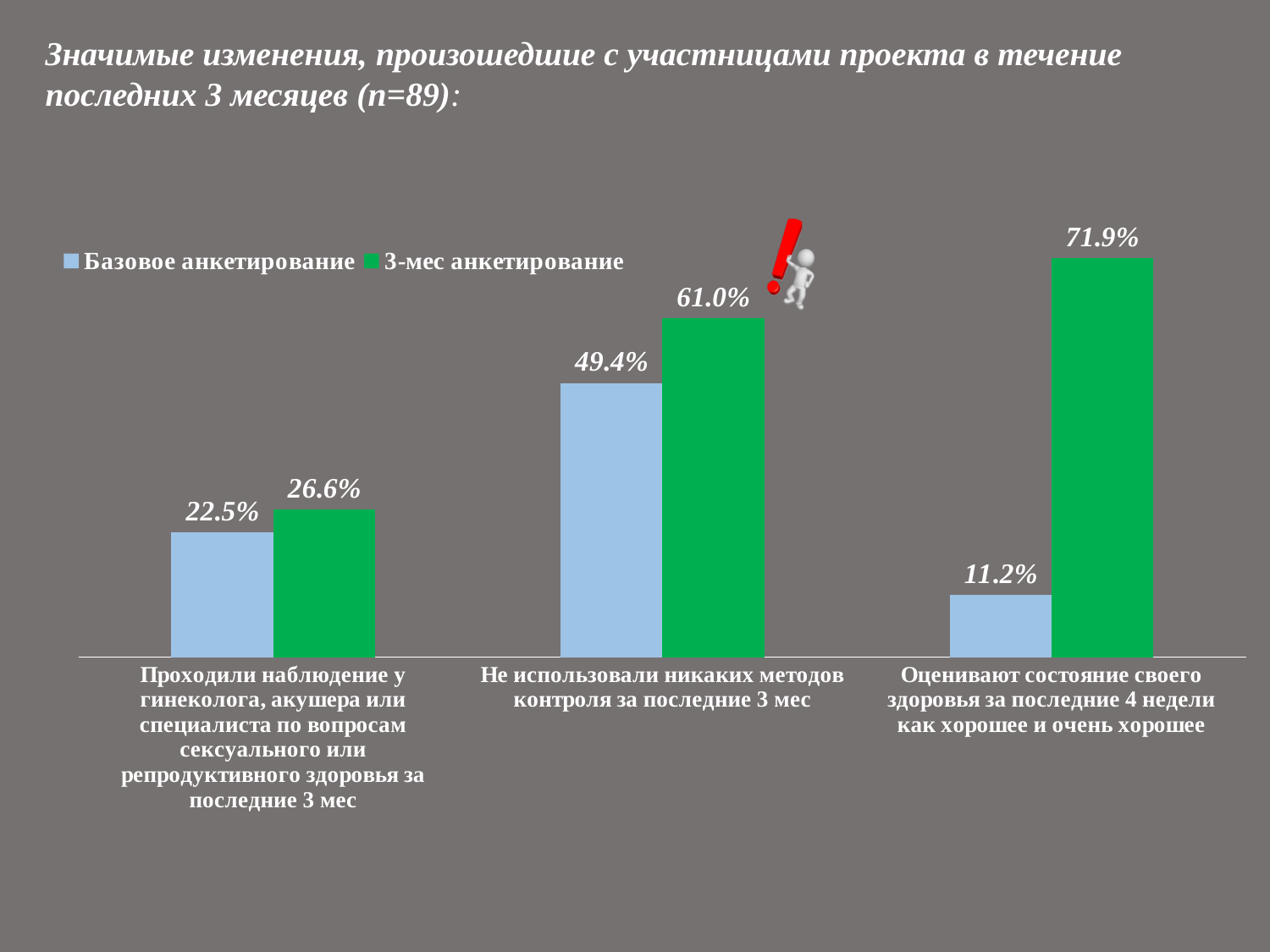
What is the difference between the "3-мес анкетирование" and "Базовое анкетирование" values for "Оценивают состояние своего здоровья за последние 4 недели как хорошее и очень хорошее"? 60.7% What kind of chart is shown on the slide? Bar chart What is the value for "3-мес анкетирование" in the category "Проходили наблюдение у гинеколога, акушера или специалиста по вопросам сексуального или репродуктивного здоровья за последние 3 мес"? 26.6% Which category has the highest value for "3-мес анкетирование"? Оценивают состояние своего здоровья за последние 4 недели как хорошее и очень хорошее Which is larger: the "Базовое анкетирование" value for "Не использовали никаких методов контроля за последние 3 мес" or the "3-мес анкетирование" value for "Проходили наблюдение у гинеколога..."? Базовое анкетирование for Не использовали никаких методов контроля за последние 3 мес What is the difference between the "3-мес анкетирование" and "Базовое анкетирование" values for "Не использовали никаких методов контроля за последние 3 мес"? 11.6% How many series does the legend list? 2 How many categories are shown on the x axis? 3 Which colour represents the "3-мес анкетирование" series? Green What is the value for "3-мес анкетирование" in the category "Оценивают состояние своего здоровья за последние 4 недели как хорошее и очень хорошее"? 71.9% What is the value for "Базовое анкетирование" in the category "Не использовали никаких методов контроля за последние 3 мес"? 49.4% Which category has the lowest value for "Базовое анкетирование"? Оценивают состояние своего здоровья за последние 4 недели как хорошее и очень хорошее